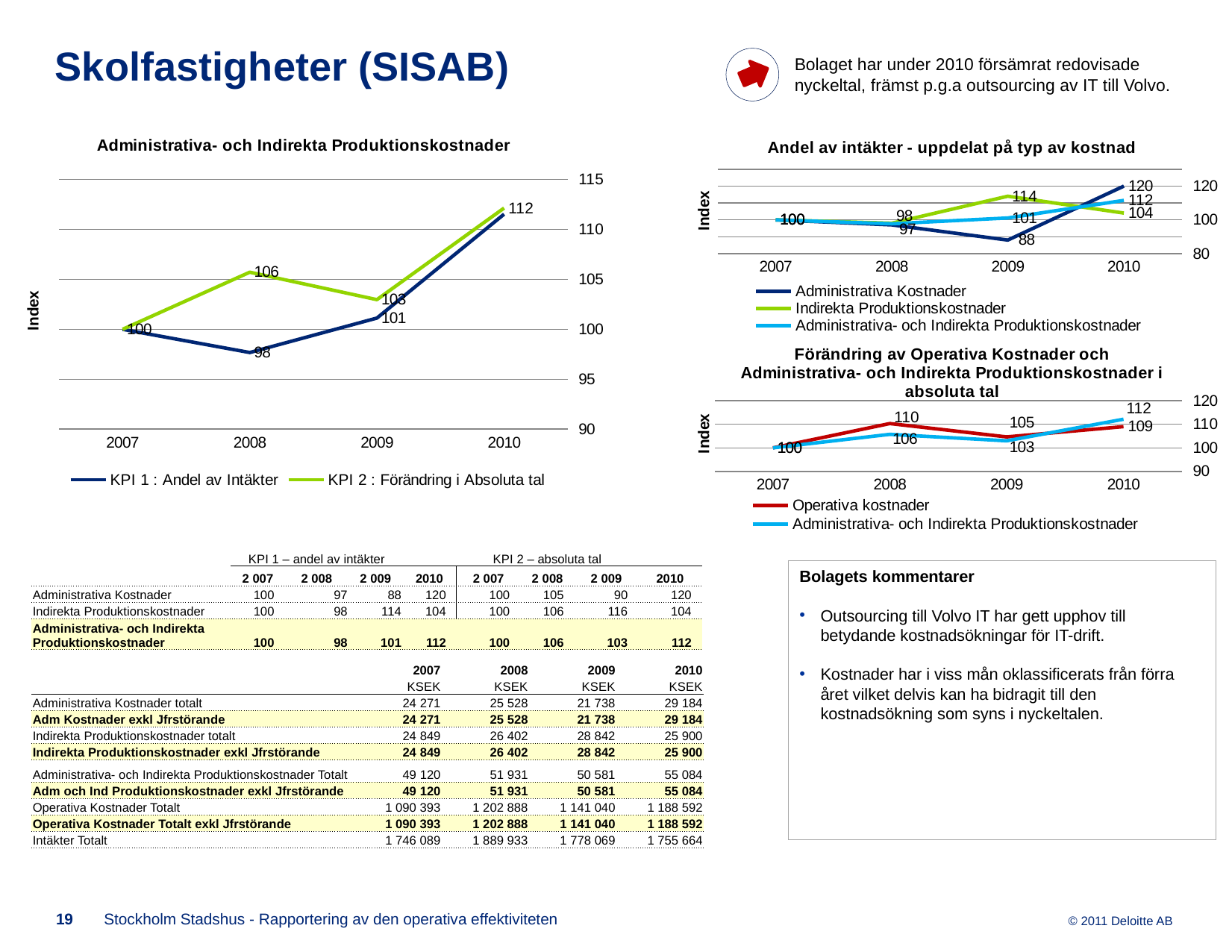
In the chart titled "Förändring av Operativa Kostnader och Administrativa- och Indirekta Produktionskostnader i absoluta tal", how many years are shown on the x axis? 4 In the chart titled "Administrativa- och Indirekta Produktionskostnader", what is the difference between KPI 2 and KPI 1 in 2008? 8 In the chart titled "Andel av intäkter - uppdelat på typ av kostnad", which series has the highest value in 2010? Administrativa Kostnader In the chart titled "Förändring av Operativa Kostnader och Administrativa- och Indirekta Produktionskostnader i absoluta tal", what is the value of Operativa kostnader in 2008? 110 In the chart titled "Administrativa- och Indirekta Produktionskostnader", how many series does the legend list? 2 In the chart titled "Förändring av Operativa Kostnader och Administrativa- och Indirekta Produktionskostnader i absoluta tal", which series has the larger value in 2010? Administrativa- och Indirekta Produktionskostnader In the chart titled "Andel av intäkter - uppdelat på typ av kostnad", what is the value of Administrativa Kostnader in 2009? 88 In the chart titled "Administrativa- och Indirekta Produktionskostnader", in which year is KPI 2 : Förändring i Absoluta tal highest? 2010 In the chart titled "Administrativa- och Indirekta Produktionskostnader", what is the value of KPI 2 : Förändring i Absoluta tal in 2009? 103 In the chart titled "Administrativa- och Indirekta Produktionskostnader", what is the value of KPI 1 : Andel av Intäkter in 2008? 98 In the chart titled "Andel av intäkter - uppdelat på typ av kostnad", how many series does the legend list? 3 What kind of chart is the chart titled "Administrativa- och Indirekta Produktionskostnader"? Line chart